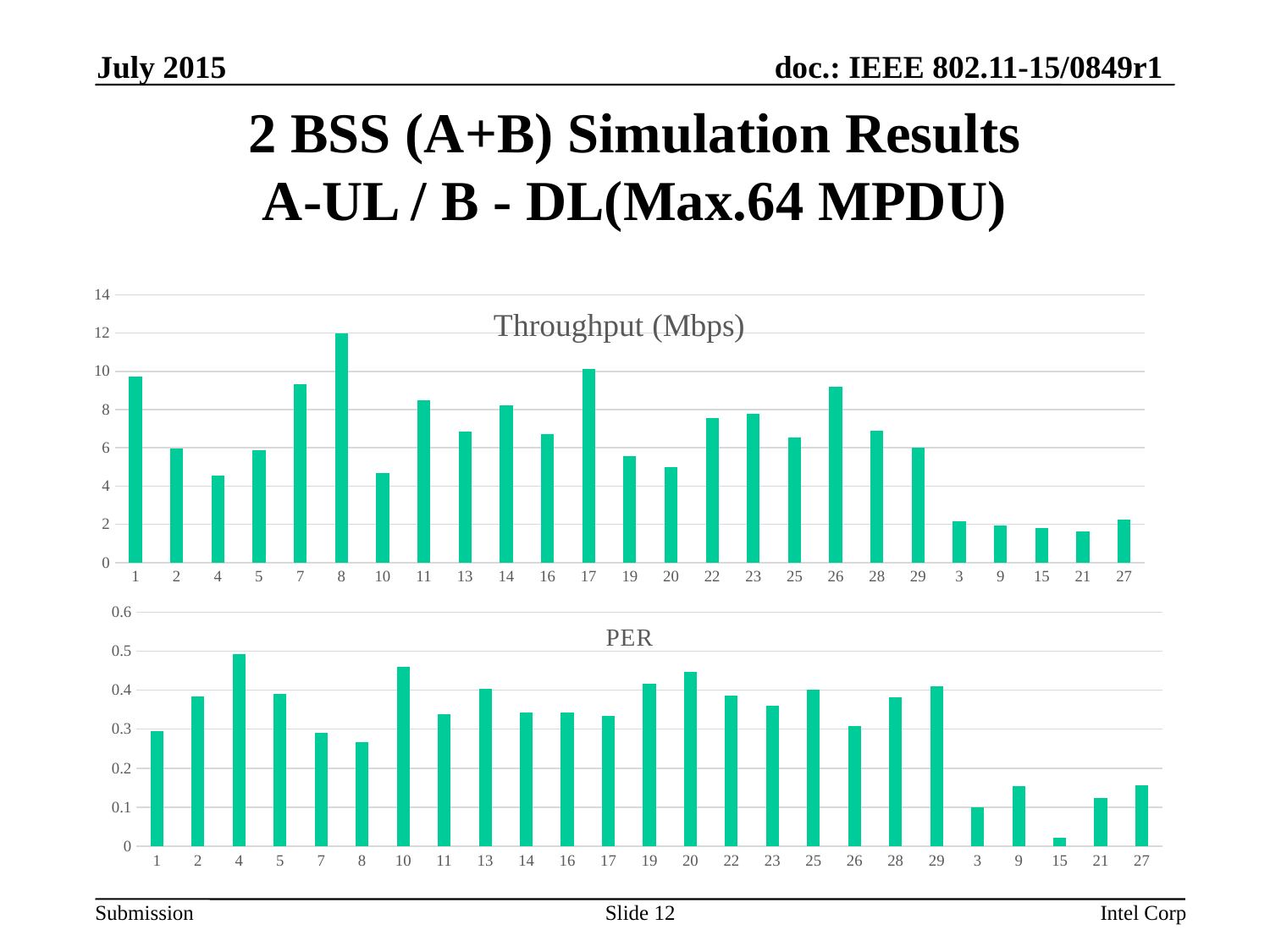
How many categories are shown on the x axis of the Throughput (Mbps) chart? 25 In the Throughput (Mbps) chart, which is larger, the value for category 8 or category 17? 8 In the PER chart, is the value for category 15 greater or less than 0.1? less In the Throughput (Mbps) chart, is the value for category 3 greater or less than 4? less In the Throughput (Mbps) chart, which category has the highest value? 8 In the PER chart, is the value for category 8 greater or less than 0.3? less What kind of chart is the Throughput (Mbps) chart? bar chart In the PER chart, which category has the highest value? 4 What is the title of the top chart on the slide? Throughput (Mbps) In the PER chart, which category has the lowest value? 15